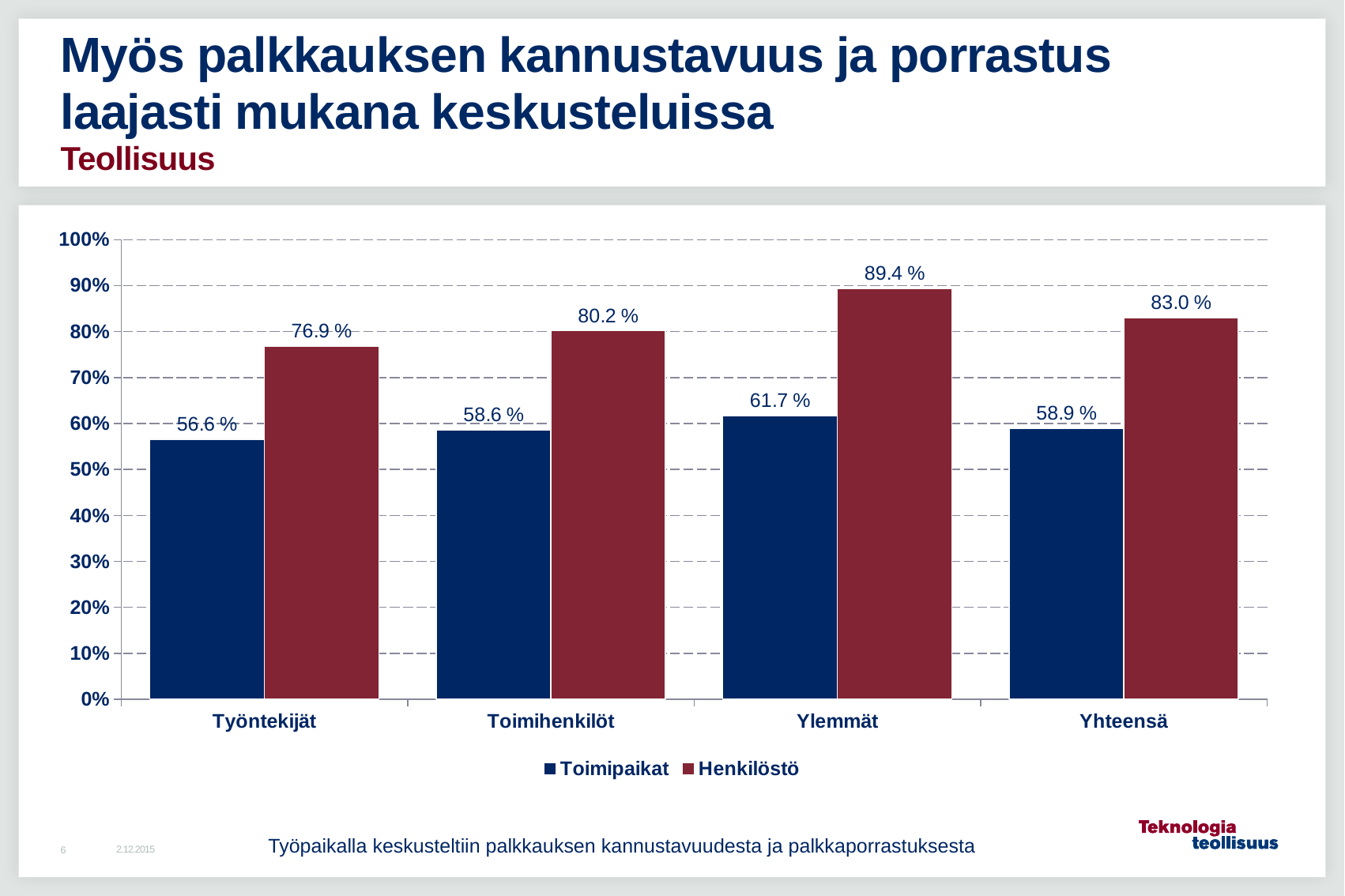
Which series is shown in dark red? Henkilöstö What kind of chart is shown on the slide? Bar chart Which is larger for Ylemmät: the Toimipaikat value or the Henkilöstö value? Henkilöstö Which category has the lowest Toimipaikat value? Työntekijät What is the Henkilöstö value for Yhteensä? 83.0 % What is the difference between the Henkilöstö and Toimipaikat values for Toimihenkilöt? 21.6 % Is the Henkilöstö value for Työntekijät greater or less than 70%? greater What is the Henkilöstö value for Ylemmät? 89.4 % How many series does the legend list? 2 What is the Toimipaikat value for Työntekijät? 56.6 % Which category has the highest Henkilöstö value? Ylemmät How many categories are shown on the x axis? 4